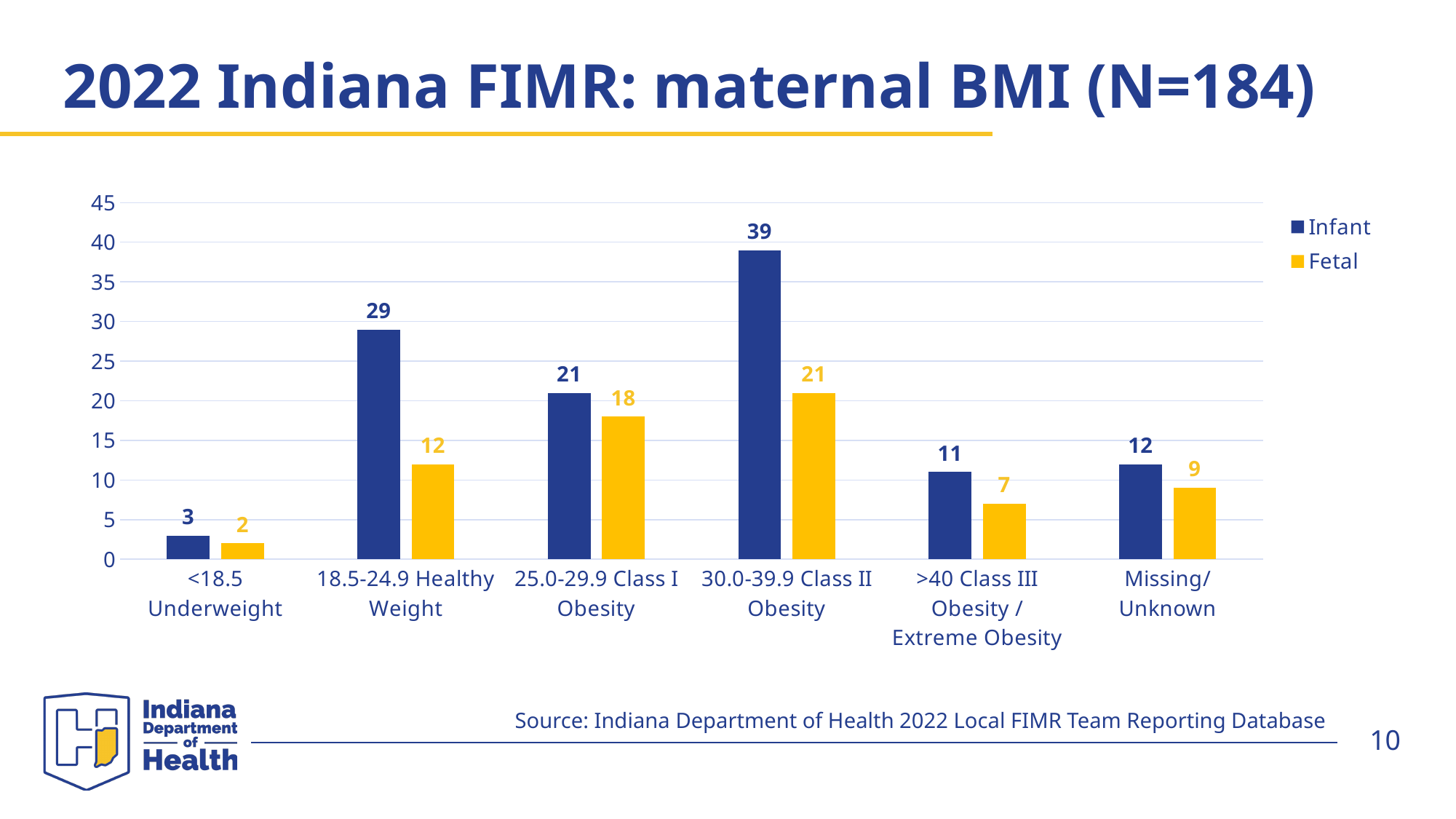
How many series does the legend list? 2 What is the Fetal value for the >40 Class III Obesity / Extreme Obesity category? 7 Which is larger for the Missing/Unknown category, the Infant value or the Fetal value? Infant How many BMI categories are shown on the x axis? 6 What is the difference between the Infant and Fetal values for the 18.5-24.9 Healthy Weight category? 17 What is the Infant value for the 30.0-39.9 Class II Obesity category? 39 Which category has the lowest Fetal value? <18.5 Underweight What kind of chart is shown on the slide? Bar chart Which colour represents the Fetal series in the chart? Yellow Which category has the highest Infant value? 30.0-39.9 Class II Obesity What is the Fetal value for the 18.5-24.9 Healthy Weight category? 12 What is the difference between the Infant values for 30.0-39.9 Class II Obesity and 25.0-29.9 Class I Obesity? 18